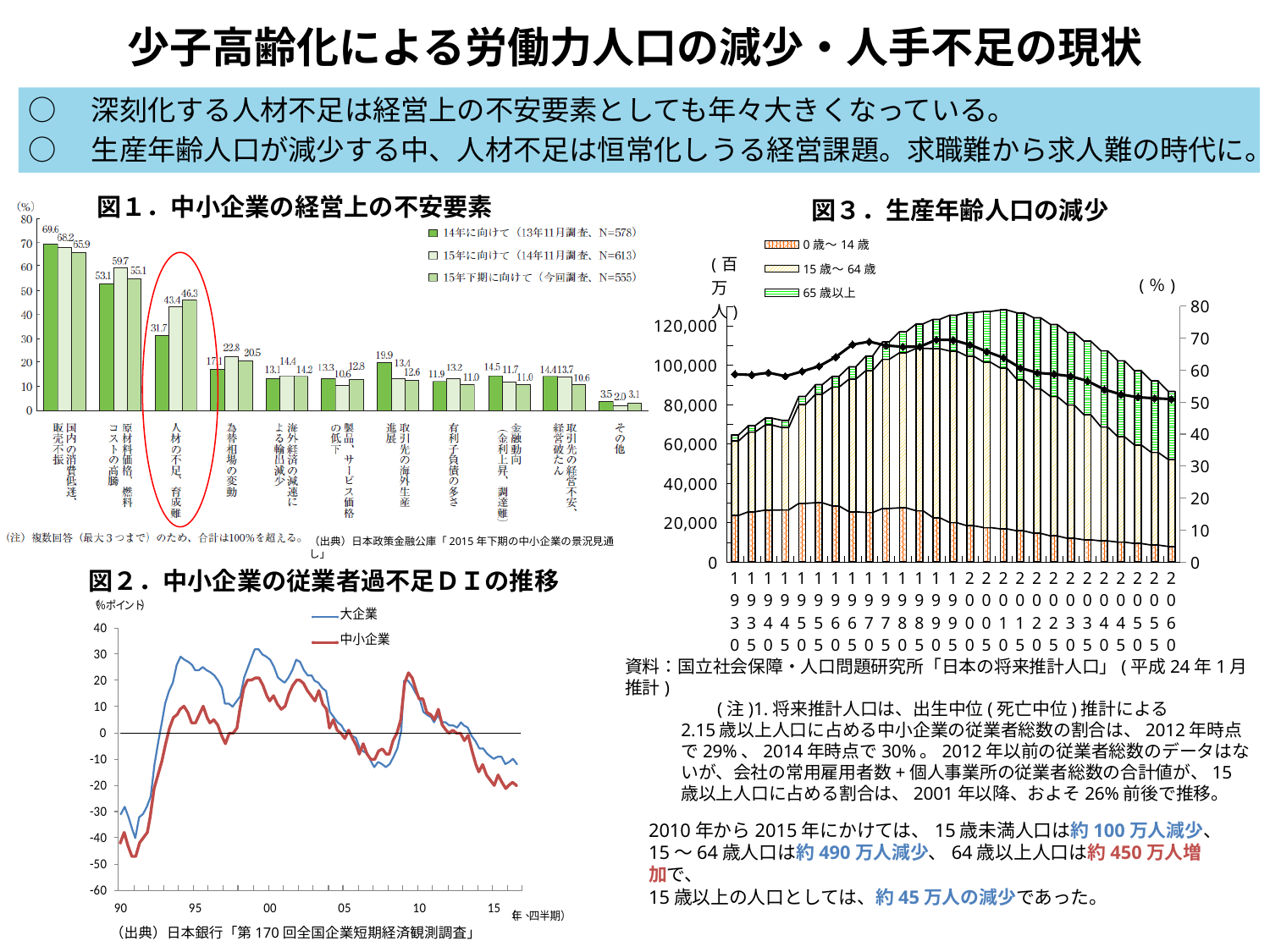
What kind of chart is 図２ (中小企業の従業者過不足ＤＩの推移)? line chart In 図１, which category has the highest value in the 15年下期に向けて series? 国内の消費低迷、販売不振 In 図１, what is the difference between the 15年下期に向けて value and the 14年に向けて value for 人材の不足、育成難? 14.6 In 図１, what is the value for 人材の不足、育成難 in the 15年下期に向けて series? 46.3 In 図１, do the values for 人材の不足、育成難 rise or fall across the three surveys from 14年に向けて to 15年下期に向けて? rise In 図１, which is larger in the 15年に向けて series: 原材料価格、燃料コストの高騰 or 為替相場の変動? 原材料価格、燃料コストの高騰 What kind of chart is 図１ (中小企業の経営上の不安要素)? bar chart How many series does the legend of 図３ (生産年齢人口の減少) list? 3 In 図１, which category has the lowest value in the 15年に向けて series? その他 How many series does the legend of 図２ list? 2 In 図１, what is the value for 国内の消費低迷、販売不振 in the 14年に向けて series? 69.6 How many series does the legend of 図１ list? 3